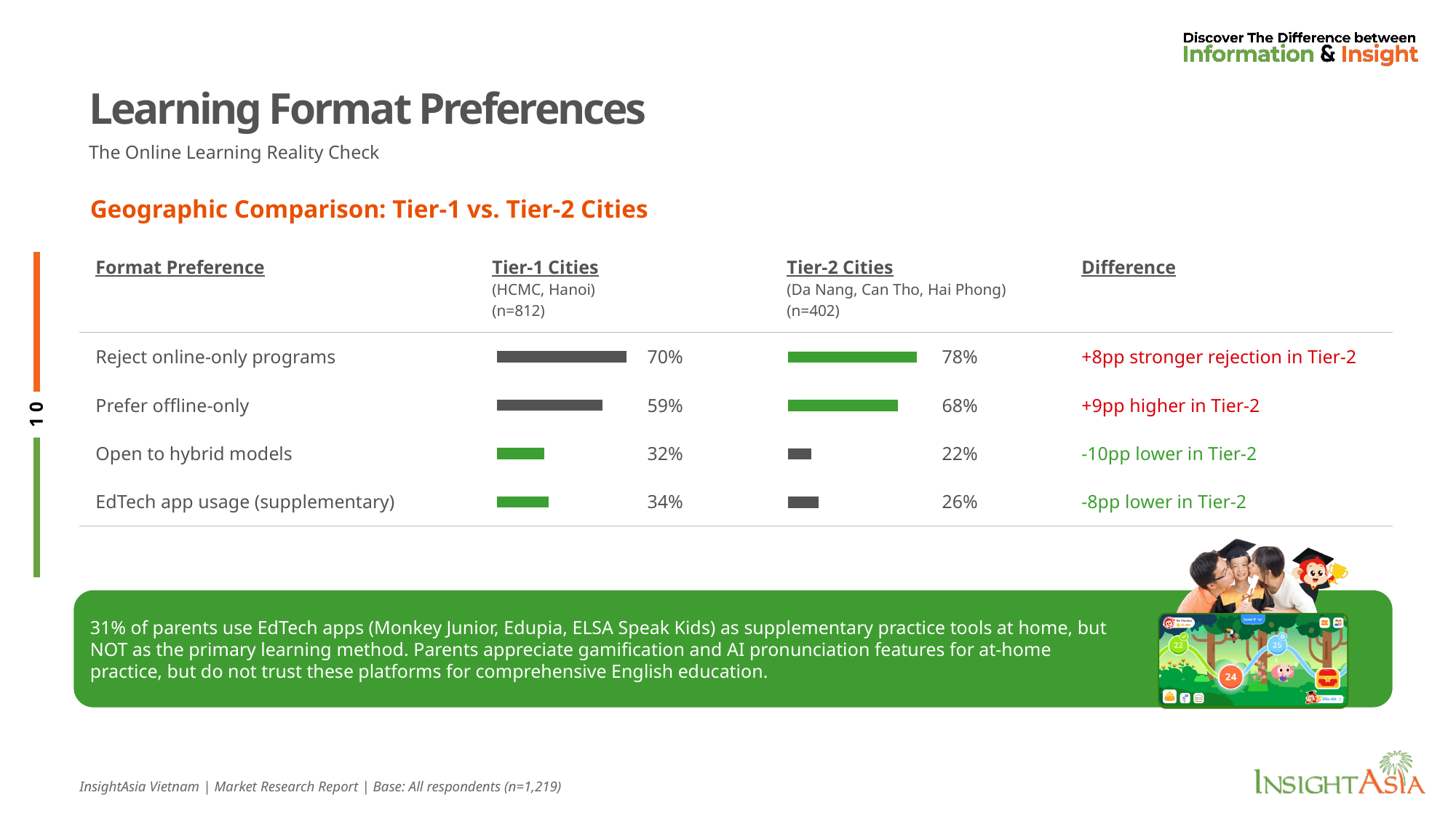
Which cities make up the Tier-1 Cities group? HCMC, Hanoi What percentage of Tier-1 Cities respondents reject online-only programs? 70% How many format preferences are compared in the table? 4 Which format preference has the highest value for Tier-2 Cities? Reject online-only programs Which is larger for 'Open to hybrid models': the Tier-1 Cities value or the Tier-2 Cities value? Tier-1 Cities What is the Tier-1 Cities value for 'EdTech app usage (supplementary)'? 34% What kind of chart is used to show the values in the Tier-1 and Tier-2 columns? Bar chart What is the sample size (n) for Tier-2 Cities? 402 What percentage of Tier-2 Cities respondents prefer offline-only? 68% What is the difference between the Tier-2 and Tier-1 values for 'Prefer offline-only'? 9pp Which format preference has the lowest value for Tier-1 Cities? Open to hybrid models What is the Tier-2 Cities value for 'Open to hybrid models'? 22%